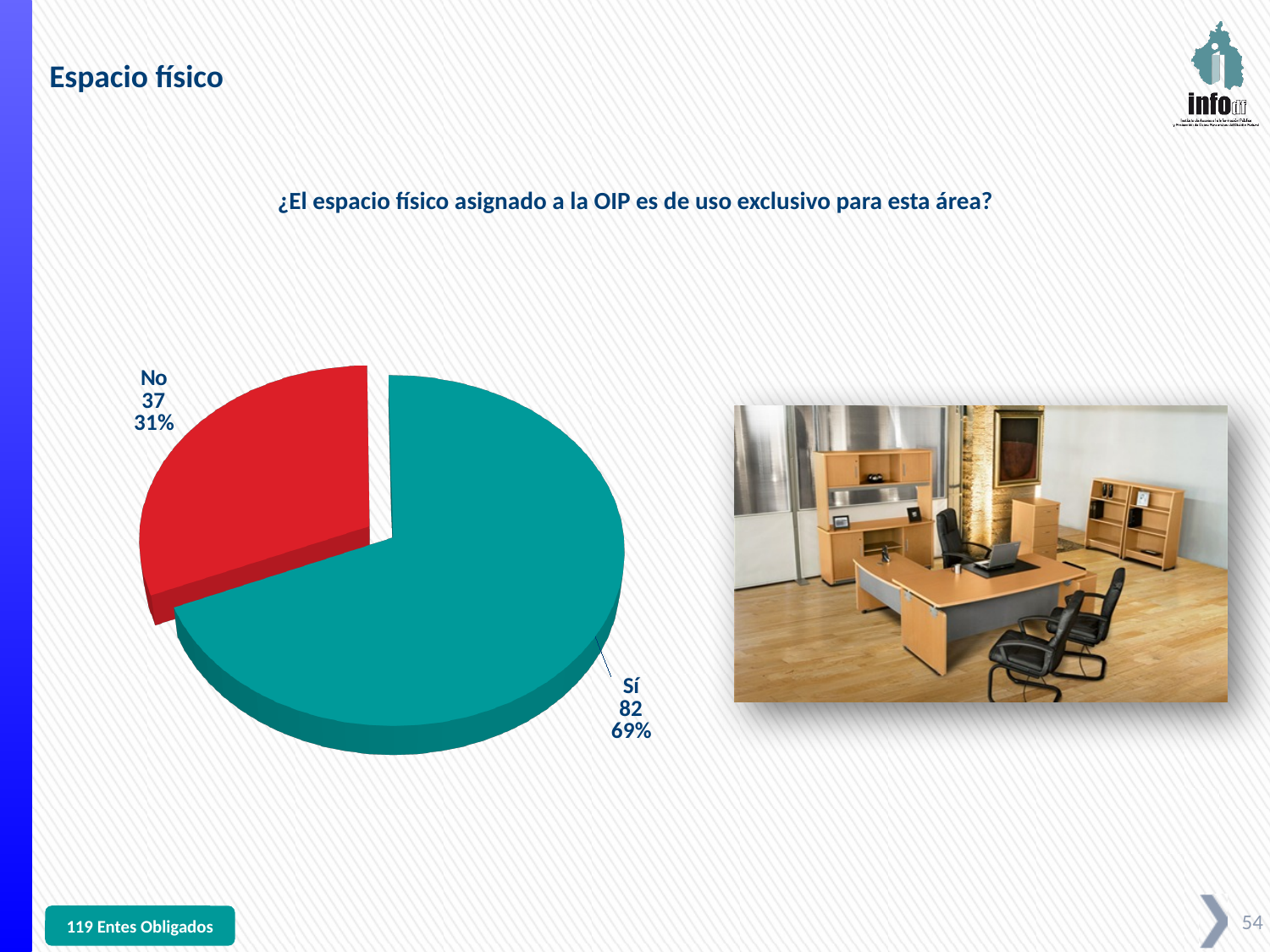
Which category has the largest slice? Sí What colour is the "No" slice? red What is the difference between the number of "Sí" and "No" responses? 45 How many slices does the pie chart have? 2 What is the total of the two slices in the pie chart? 119 How many entities answered "Sí"? 82 What kind of chart is shown on the slide? pie chart How many entities answered "No"? 37 What percentage of the pie does the "Sí" slice represent? 69% What percentage of the pie does the "No" slice represent? 31% Which is larger, the "Sí" slice or the "No" slice? Sí Which category has the smallest slice? No